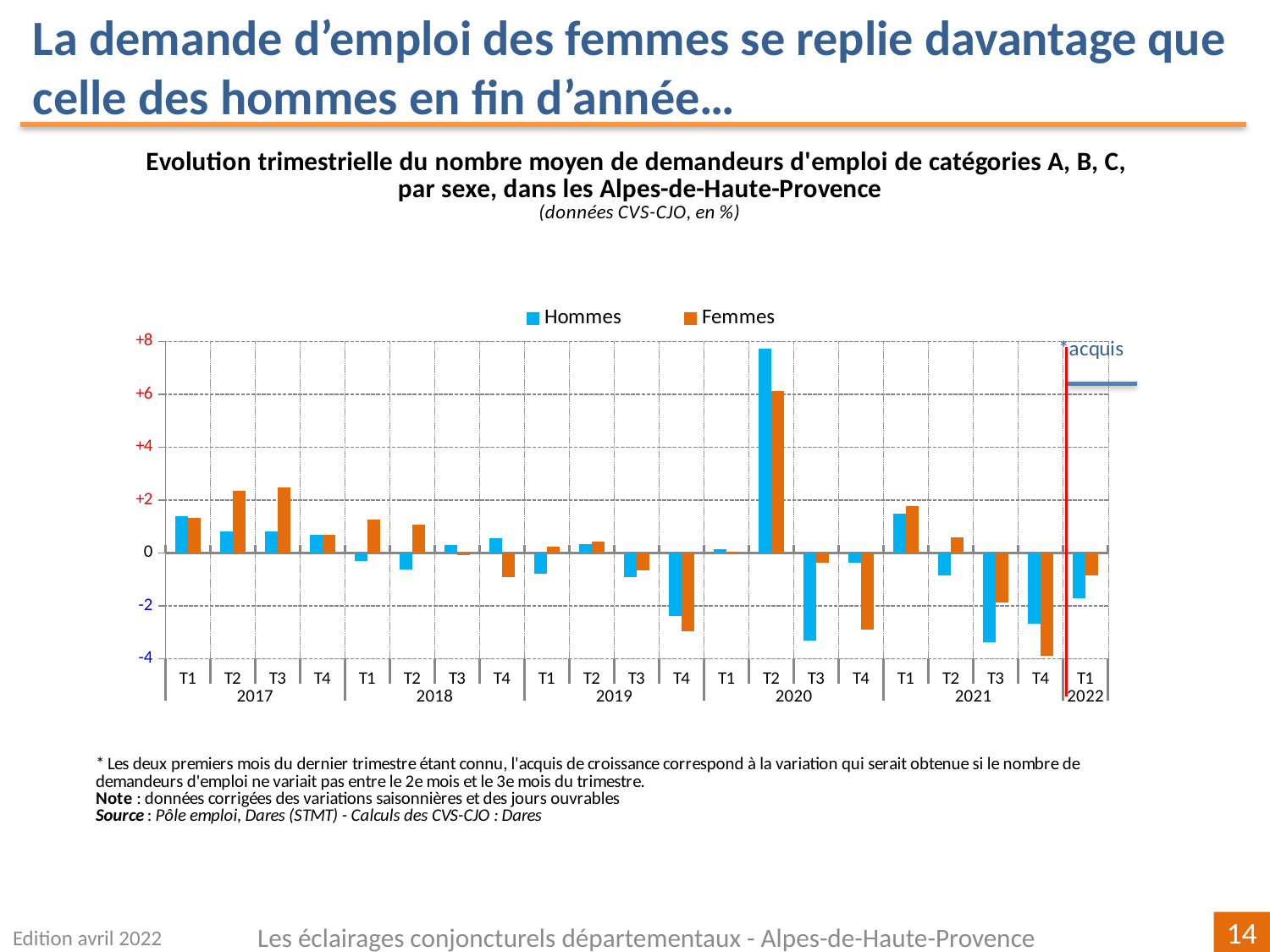
In T2 2020, which series has the larger value, Hommes or Femmes? Hommes Is the value for Femmes in T4 2021 greater or less than -2? less What kind of chart is shown on the slide? bar chart Which series are listed in the legend? Hommes and Femmes In which quarter is the value for Femmes highest? T2 2020 In which quarter is the value for Hommes highest? T2 2020 Is the value for Hommes in T2 2020 greater or less than +6? greater Is the value for Femmes in T3 2017 greater or less than +2? greater How many quarters are plotted on the x axis? 21 In T3 2020, which series has the larger value, Hommes or Femmes? Femmes How many series does the legend list? 2 In which quarter is the value for Femmes lowest? T4 2021